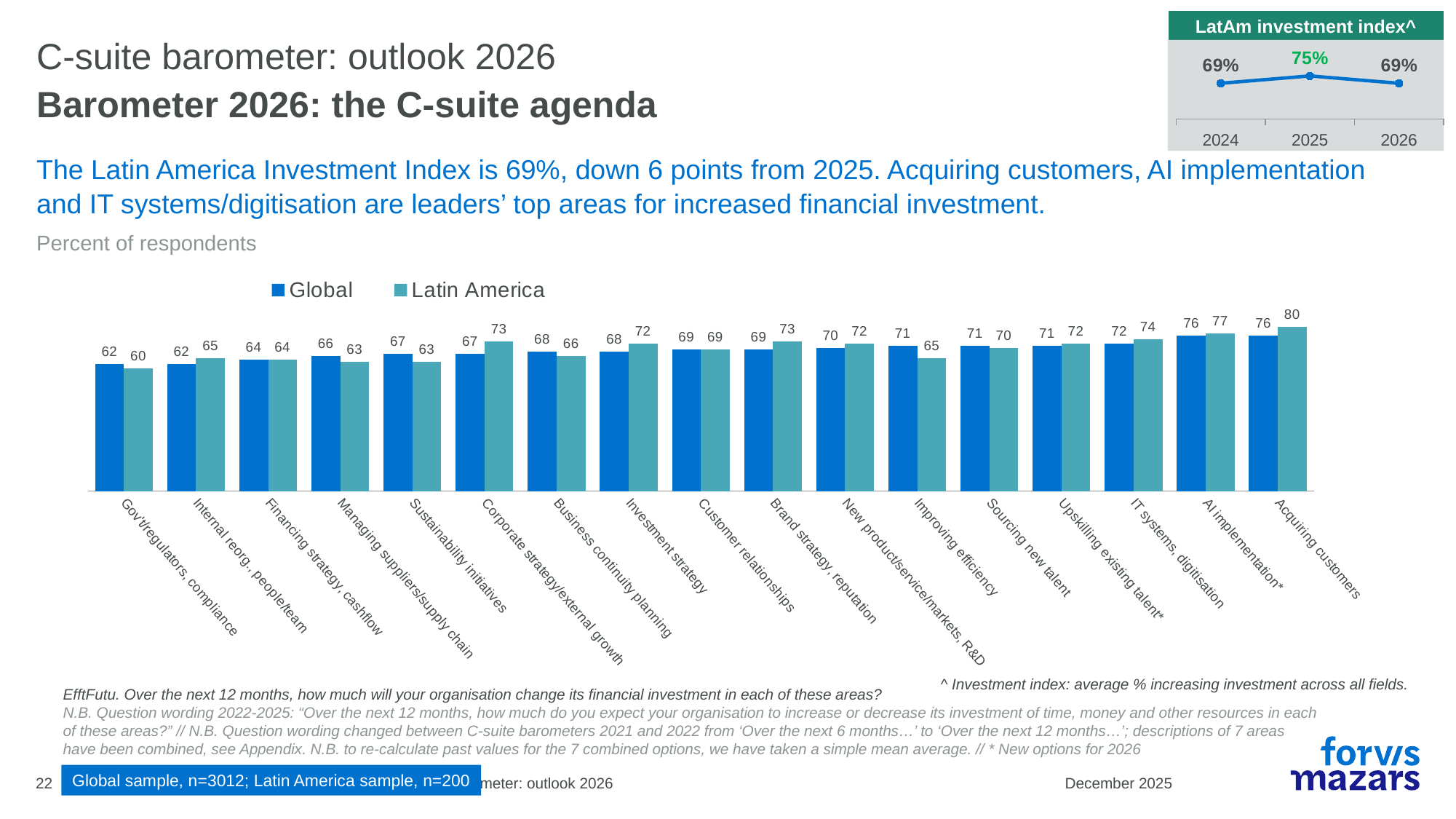
In the main bar chart, which is larger for Improving efficiency: the Global value or the Latin America value? Global In the main bar chart, which category has the highest Latin America value? Acquiring customers What are the two series named in the legend of the main bar chart? Global and Latin America In the main bar chart, which category has the lowest Latin America value? Gov't/regulators, compliance In the main bar chart, what is the difference between the Latin America and Global values for Corporate strategy/external growth? 6 How many categories are shown on the x axis of the main bar chart? 17 In the main bar chart, what is the Global value for Improving efficiency? 71 In the LatAm investment index chart at the top right, what is the value for 2025? 75% In the main bar chart, what is the Latin America value for Acquiring customers? 80 In the LatAm investment index chart at the top right, what is the difference between the 2025 and 2026 values? 6 points What kind of chart is the main chart on the slide? Bar chart How many series does the legend of the main bar chart list? 2